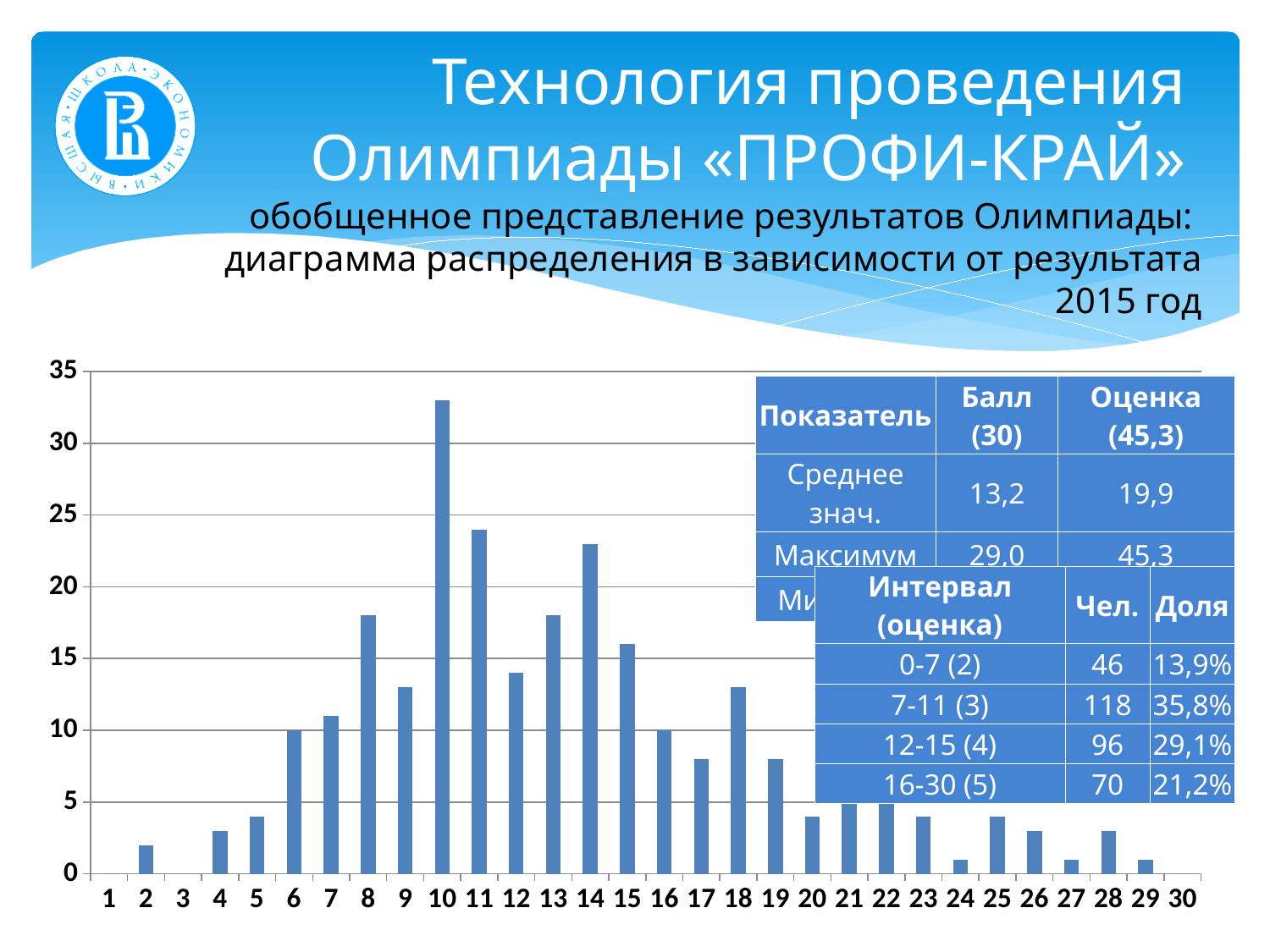
Is the value for category 10 greater or less than 30? greater Is the value for category 2 greater or less than 5? less Is the value for category 11 greater or less than 20? greater Do the bar values generally rise or fall from category 10 to category 30? fall What is the highest value shown on the y axis of the chart? 35 How many categories are shown along the x axis of the chart? 30 Which is larger, the value for category 14 or the value for category 15? 14 Which is larger, the value for category 5 or the value for category 6? 6 Which category has the highest bar in the chart? 10 What kind of chart is shown on the slide? bar chart